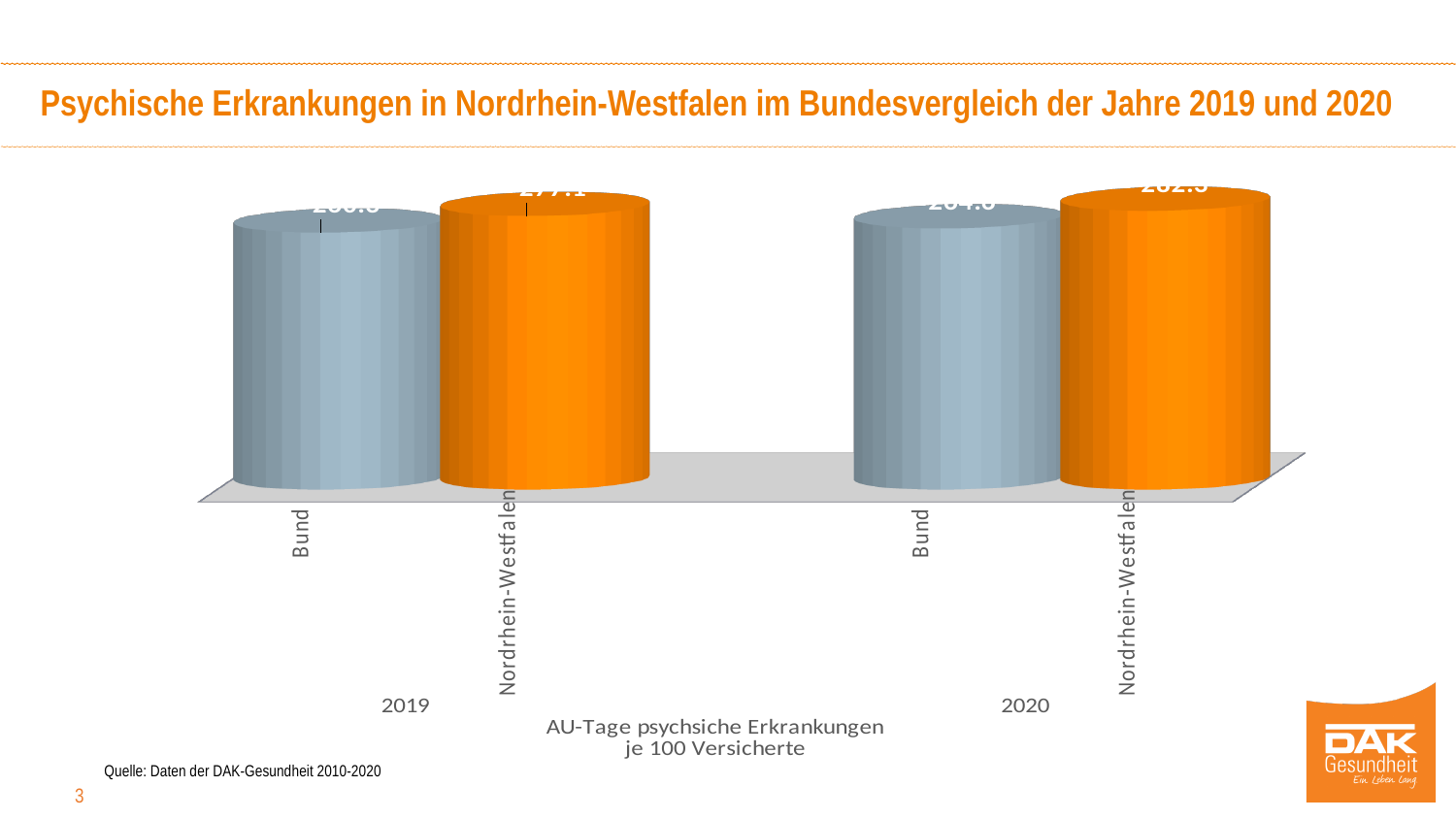
In 2020, which has the larger value: Bund or Nordrhein-Westfalen? Nordrhein-Westfalen Within each year, is the value for Nordrhein-Westfalen higher or lower than the value for Bund? Higher What kind of chart is shown on the slide? Bar chart In 2019, which has the larger value: Bund or Nordrhein-Westfalen? Nordrhein-Westfalen How many bars are plotted in the chart? 4 What is the title of the slide? Psychische Erkrankungen in Nordrhein-Westfalen im Bundesvergleich der Jahre 2019 und 2020 Which two regions are compared in the chart? Bund and Nordrhein-Westfalen What colour are the bars for Nordrhein-Westfalen? Orange Which two years are compared in the chart? 2019 and 2020